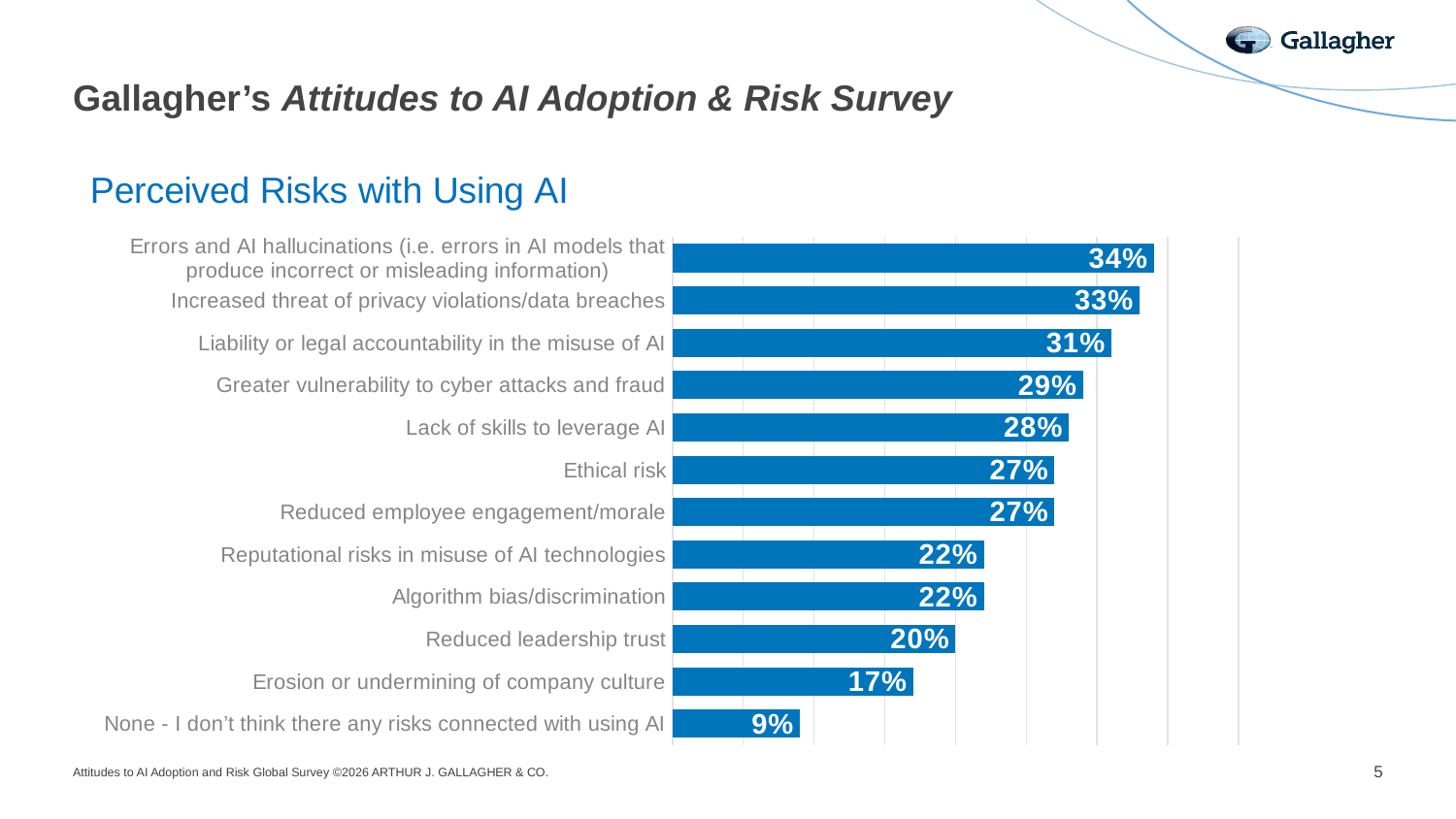
What is the title of the chart? Perceived Risks with Using AI What is the value for 'Reputational risks in misuse of AI technologies'? 22% What percentage of respondents cited 'Increased threat of privacy violations/data breaches' as a perceived risk? 33% What is the difference between the values for 'Liability or legal accountability in the misuse of AI' and 'Reduced leadership trust'? 11% Which is larger: the value for 'Greater vulnerability to cyber attacks and fraud' or the value for 'Algorithm bias/discrimination'? Greater vulnerability to cyber attacks and fraud What is the value for 'Erosion or undermining of company culture'? 17% What is the difference between the highest and lowest values on the chart? 25% How many categories are shown on the chart? 12 Which category has the lowest value on the chart? None - I don't think there any risks connected with using AI What kind of chart is shown on the slide? Bar chart What is the value for 'Lack of skills to leverage AI'? 28% Which perceived risk has the highest percentage? Errors and AI hallucinations (i.e. errors in AI models that produce incorrect or misleading information)